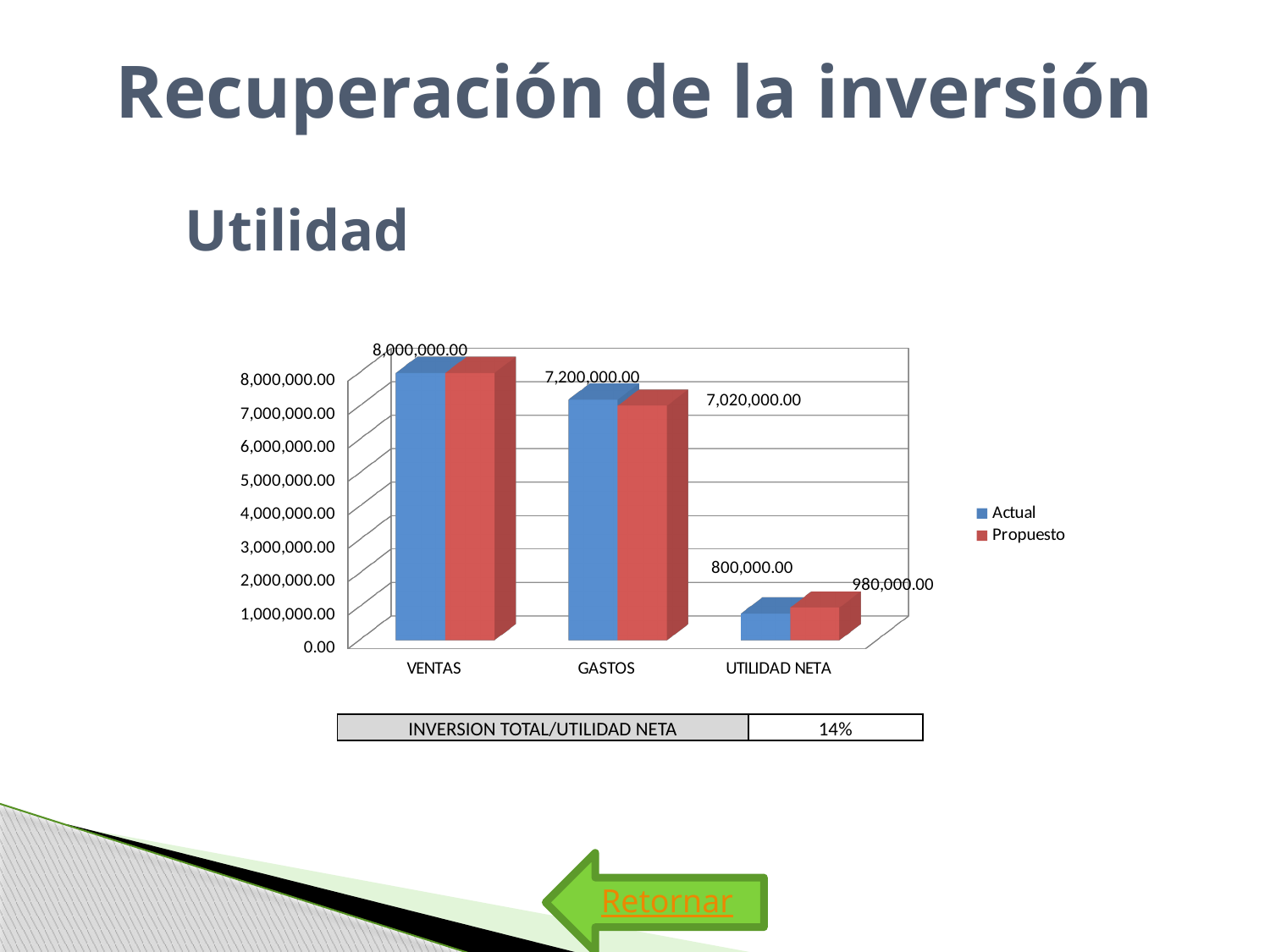
Which category has the highest values in the chart? VENTAS What is the Propuesto value for GASTOS? 7,020,000.00 For UTILIDAD NETA, which series has the larger value, Actual or Propuesto? Propuesto What is the Actual value for GASTOS? 7,200,000.00 What is the Actual value for UTILIDAD NETA? 800,000.00 What is the difference between the Actual and Propuesto values for GASTOS? 180,000.00 Is the Propuesto value for VENTAS greater or less than 7,000,000.00? greater Which category has the lowest values in the chart? UTILIDAD NETA What is the Propuesto value for UTILIDAD NETA? 980,000.00 How many series does the chart legend list? 2 How many categories are shown on the x axis of the chart? 3 By how much does the Propuesto value for UTILIDAD NETA exceed the Actual value? 180,000.00